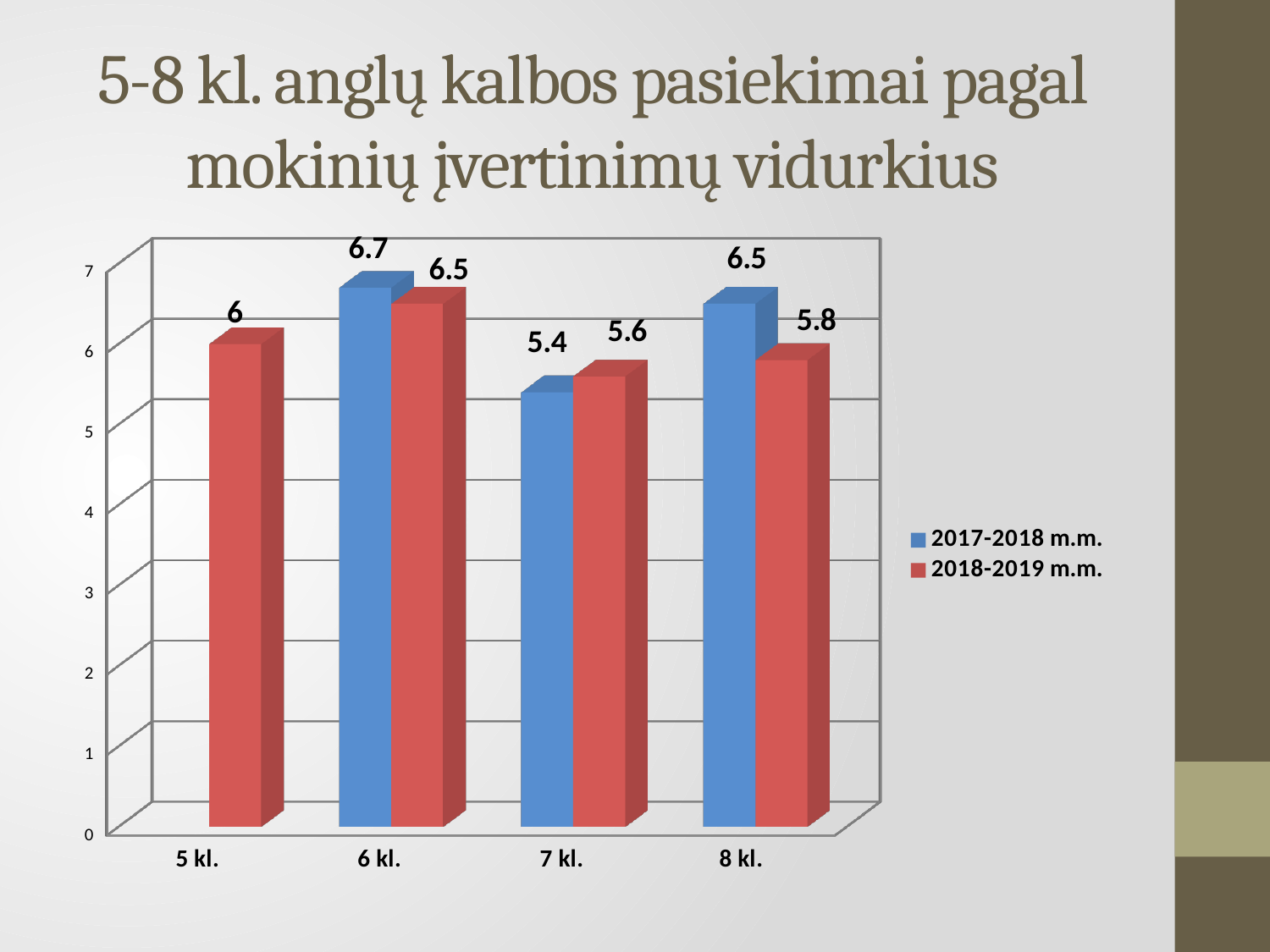
What is the value for 8 kl. in the 2018-2019 m.m. series? 5.8 What is the value for 5 kl. in the 2018-2019 m.m. series? 6 Which class has the lowest value in the 2017-2018 m.m. series? 7 kl. How many classes are shown on the x axis? 4 What is the value for 7 kl. in the 2017-2018 m.m. series? 5.4 Which class has the highest value in the 2018-2019 m.m. series? 6 kl. What kind of chart is shown on the slide? Bar chart What is the value for 6 kl. in the 2017-2018 m.m. series? 6.7 What is the difference between the 2017-2018 m.m. and 2018-2019 m.m. values for 8 kl.? 0.7 How many series does the legend list? 2 Is the value for 6 kl. in the 2018-2019 m.m. series greater or less than 6? greater For 7 kl., which series has the larger value, 2017-2018 m.m. or 2018-2019 m.m.? 2018-2019 m.m.